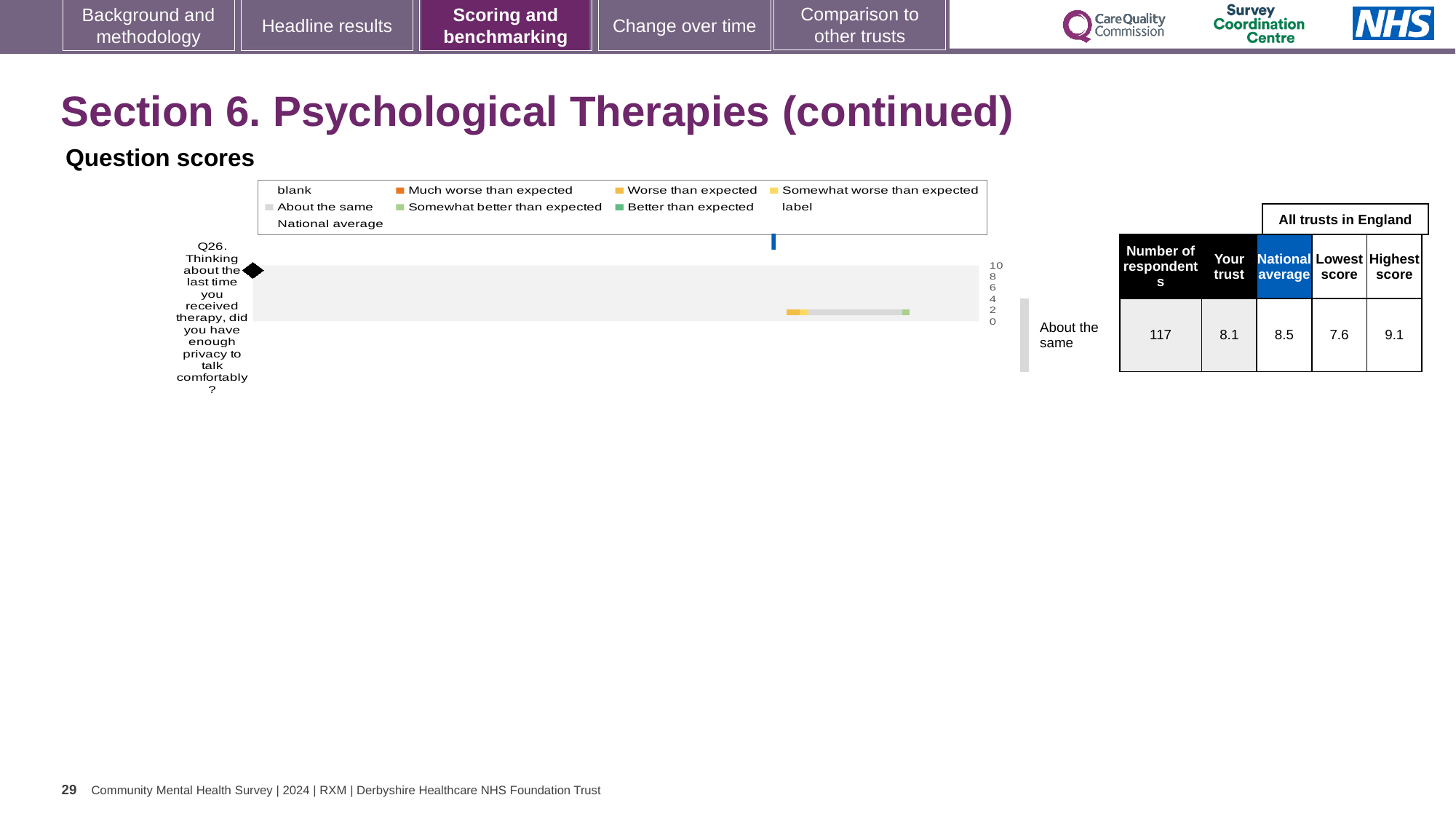
What colour represents 'Much worse than expected' in the chart legend? Orange What kind of chart is used to show the Q26 question score? bar chart What is the national average score for Q26? 8.5 What is the highest score among all trusts in England for Q26? 9.1 By how much does the national average exceed the 'Your trust' score for Q26? 0.4 What is the 'Your trust' score for Q26 about having enough privacy to talk comfortably? 8.1 Which is higher for Q26, the 'Your trust' score or the national average? National average Which benchmark category is Q26 placed in? About the same How many respondents answered Q26? 117 What is the difference between the highest score and the lowest score for Q26? 1.5 How many survey questions are plotted on the chart? 1 What is the lowest score among all trusts in England for Q26? 7.6